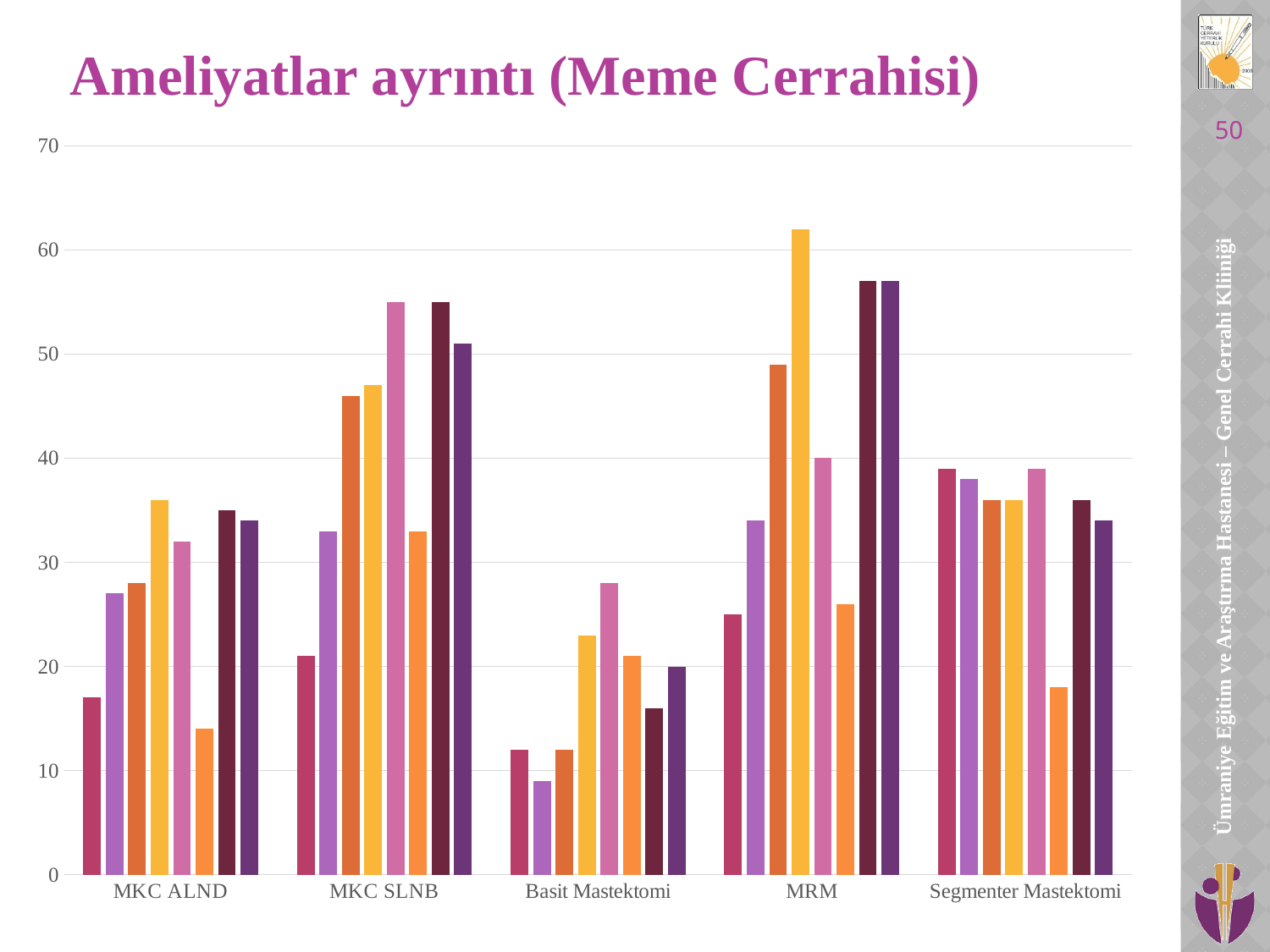
Which category contains the shortest bar in the chart? Basit Mastektomi Is the tallest bar for MRM greater or less than 60? greater What kind of chart is shown on the slide? bar chart How many bars are plotted for each category in the chart? 8 Is the tallest bar for Basit Mastektomi greater or less than 30? less How many categories are shown on the x axis of the chart? 5 Which category contains the tallest bar in the chart? MRM Is the tallest bar for MKC SLNB greater or less than 50? greater Which category has the taller highest bar, MKC SLNB or MRM? MRM What is the highest value shown on the vertical axis of the chart? 70 What is the title of the chart on the slide? Ameliyatlar ayrıntı (Meme Cerrahisi)